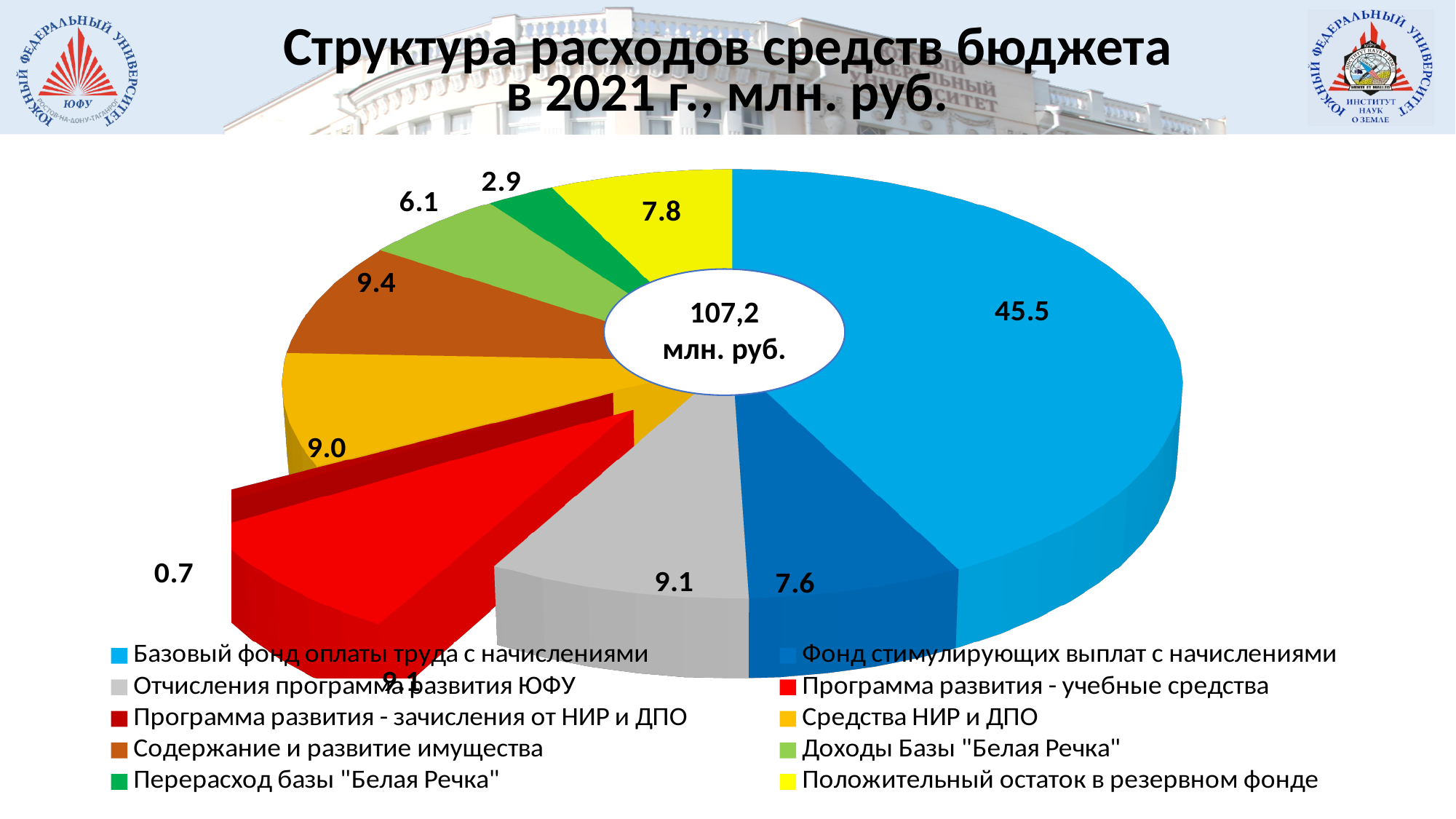
What is the value for "Фонд стимулирующих выплат с начислениями"? 7.6 What total amount is shown in the centre of the pie chart? 107,2 млн. руб. What is the value for "Положительный остаток в резервном фонде"? 7.8 What kind of chart is shown on the slide? Pie chart What is the value for "Содержание и развитие имущества"? 9.4 Which is larger: "Содержание и развитие имущества" or "Средства НИР и ДПО"? Содержание и развитие имущества Which category has the largest slice of the pie? Базовый фонд оплаты труда с начислениями How many categories does the legend list? 10 What is the value for "Базовый фонд оплаты труда с начислениями"? 45.5 Which category has the smallest slice of the pie? Программа развития - зачисления от НИР и ДПО What is the difference between the values for "Базовый фонд оплаты труда с начислениями" and "Фонд стимулирующих выплат с начислениями"? 37.9 What is the value for "Перерасход базы "Белая Речка""? 2.9